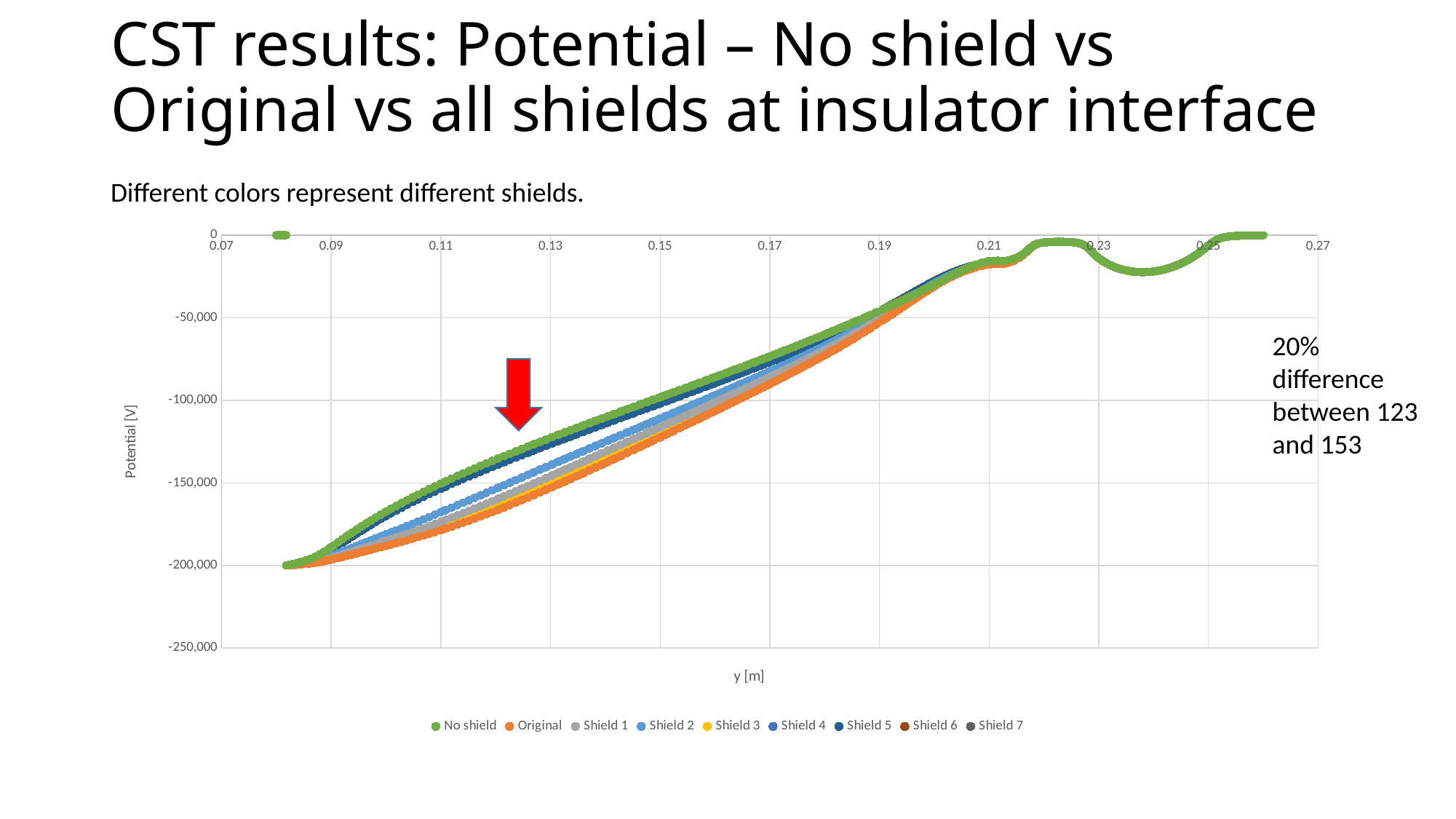
Which series lies lowest (most negative) in the region around y = 0.13? Original Is the No shield value at y = 0.13 greater or less than -100,000? less What is the lowest value shown on the vertical axis? -250,000 What is the label of the vertical axis? Potential [V] What kind of chart is shown on the slide? scatter chart At y = 0.13, which series has the higher potential, No shield or Original? No shield Do the potential values rise or fall as y increases from 0.09 to 0.21? rise Is the No shield value at y = 0.19 greater or less than -100,000? greater What is the label of the horizontal axis? y [m] What is the highest value shown on the horizontal axis? 0.27 Is the Original value at y = 0.15 greater or less than -100,000? less How many series does the legend list? 9